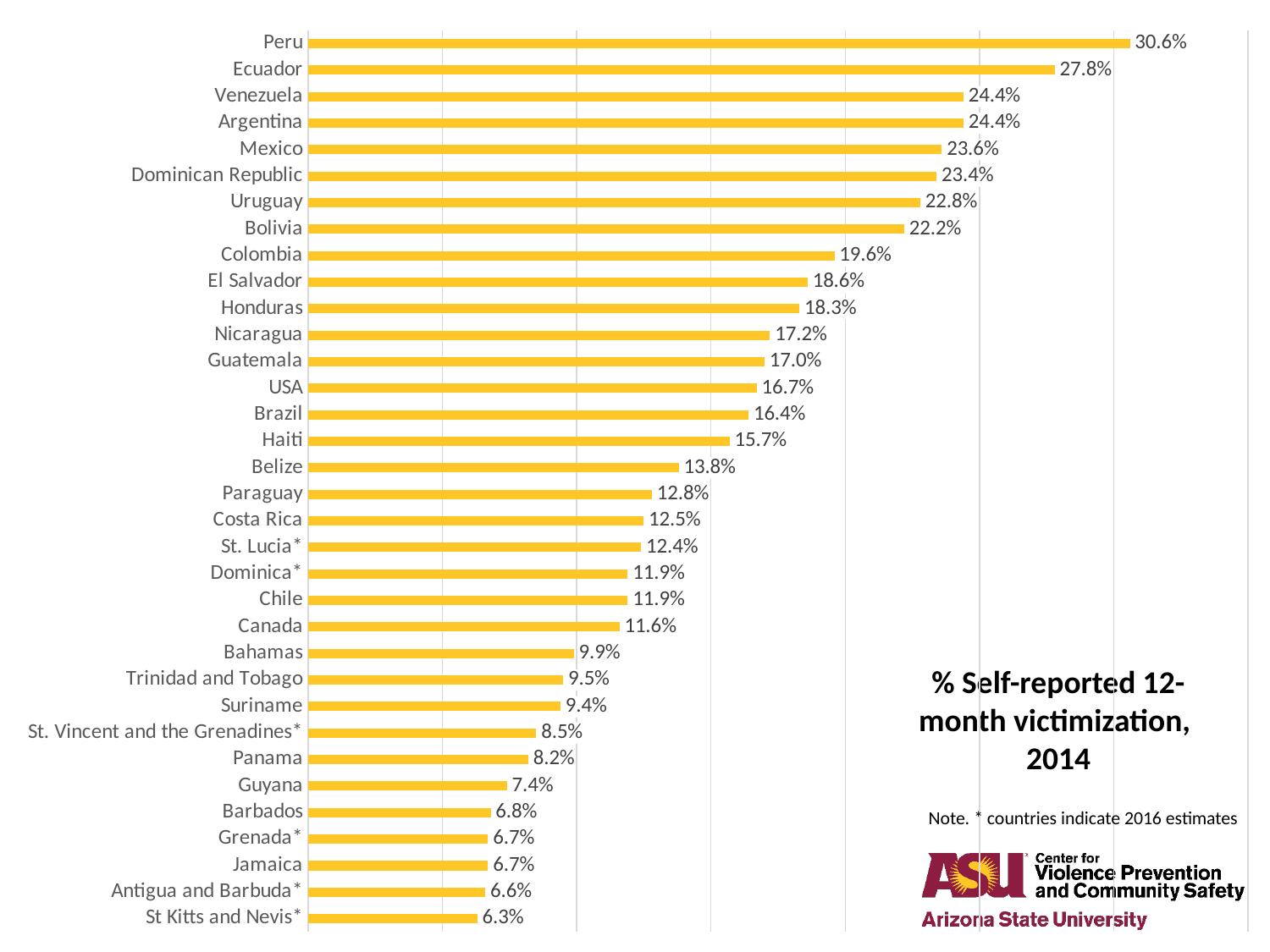
What kind of chart is this? Bar chart Which has a larger value, Mexico or Colombia? Mexico What is the value for USA? 16.7% What is the value for Canada? 11.6% Which country has the lowest value? St Kitts and Nevis* What is the difference between the values for Peru and Ecuador? 2.8 percentage points What is the title of the chart? % Self-reported 12-month victimization, 2014 What is the value for Dominican Republic? 23.4% Which country has the highest value? Peru What is the difference between the values for USA and Canada? 5.1 percentage points How many countries are shown in the chart? 34 What is the value for Peru? 30.6%